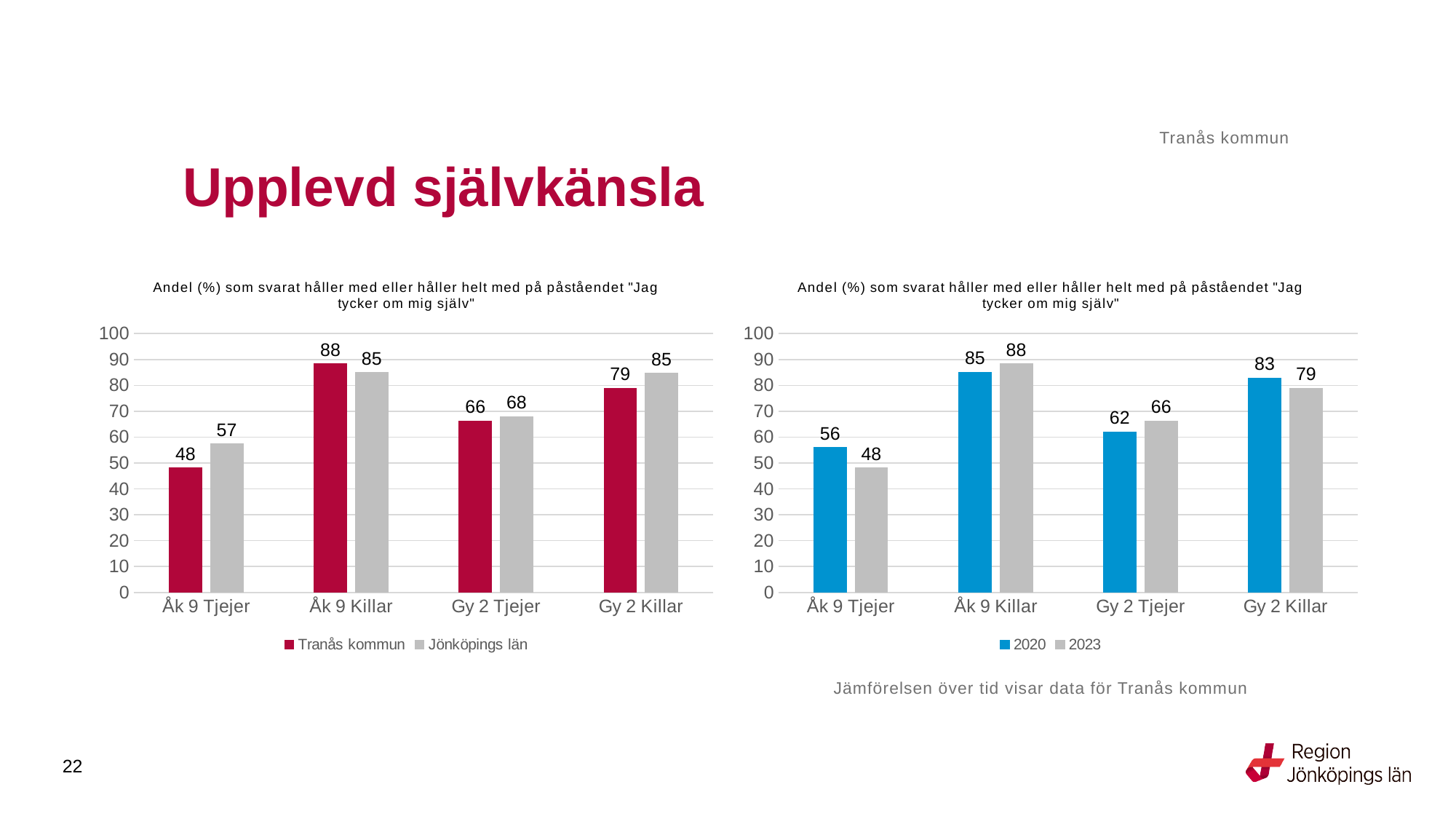
In the left chart, what is the value for Jönköpings län for Gy 2 Killar? 85 In the right chart, what is the value for 2023 for Åk 9 Killar? 88 In the left chart, what is the difference between Jönköpings län and Tranås kommun for Åk 9 Tjejer? 9 In the left chart, which category has the highest value for Tranås kommun? Åk 9 Killar In the right chart, what is the difference between 2020 and 2023 for Åk 9 Tjejer? 8 In the left chart, which is larger for Gy 2 Killar: Tranås kommun or Jönköpings län? Jönköpings län In the left chart, which category has the lowest value for Jönköpings län? Åk 9 Tjejer What kind of chart is the left chart? Bar chart How many series does the legend of the right chart list? 2 In the left chart, what is the value for Tranås kommun for Åk 9 Tjejer? 48 In the right chart, what is the value for 2020 for Gy 2 Tjejer? 62 In the right chart, which category has the lowest value for 2023? Åk 9 Tjejer